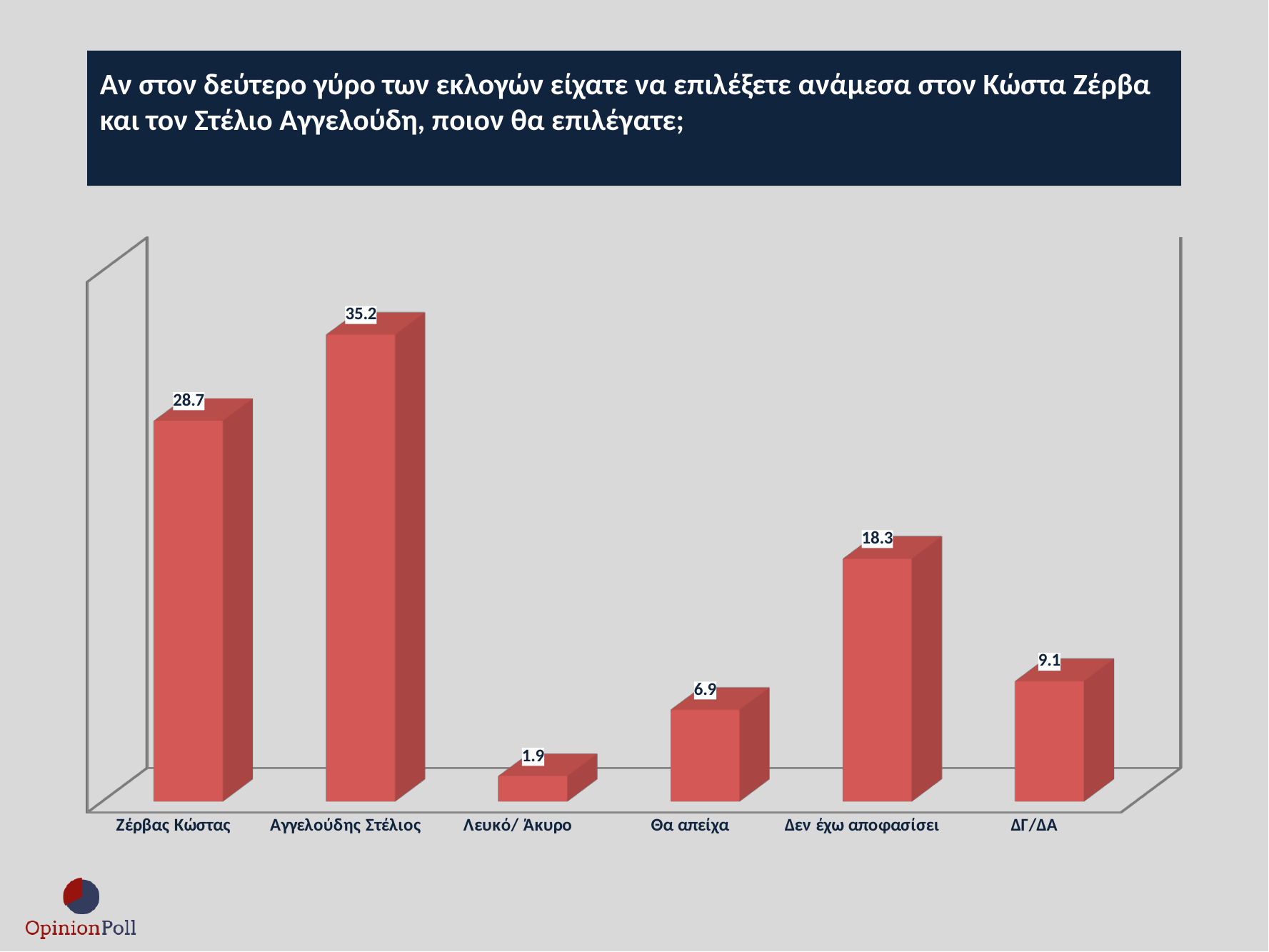
What is the value for ΔΓ/ΔΑ? 9.1 How many categories are shown on the chart? 6 What kind of chart is shown on the slide? Bar chart Which category has the highest value? Αγγελούδης Στέλιος What is the value for Λευκό/ Άκυρο? 1.9 What is the value for Ζέρβας Κώστας? 28.7 What is the difference between the values for Αγγελούδης Στέλιος and Ζέρβας Κώστας? 6.5 What is the value for Αγγελούδης Στέλιος? 35.2 What is the difference between the values for Δεν έχω αποφασίσει and Θα απείχα? 11.4 Which is larger, the value for Θα απείχα or the value for ΔΓ/ΔΑ? ΔΓ/ΔΑ What is the value for Δεν έχω αποφασίσει? 18.3 Which category has the lowest value? Λευκό/ Άκυρο